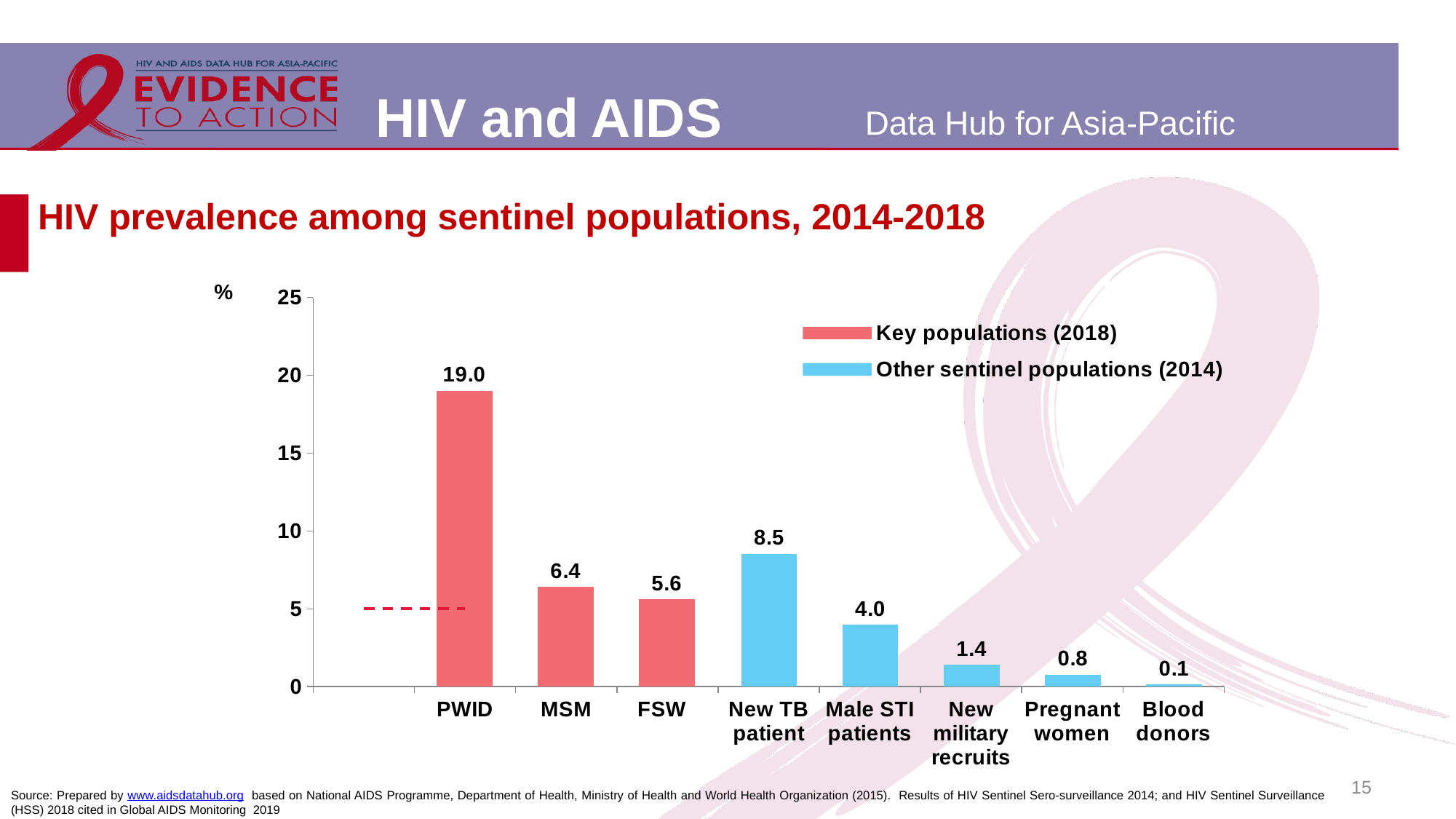
How many sentinel population categories are shown on the x axis? 8 What is the HIV prevalence value shown for PWID? 19.0 How many series does the legend list? 2 What is the difference between the HIV prevalence for PWID and for New TB patient? 10.5 What is the HIV prevalence value shown for Pregnant women? 0.8 Which has a higher HIV prevalence, Male STI patients or New military recruits? Male STI patients What kind of chart is shown on the slide? Bar chart Which sentinel population has the highest HIV prevalence on the chart? PWID Is the value for FSW greater or less than 5? greater What is the difference between the HIV prevalence for MSM and for FSW? 0.8 What is the HIV prevalence value shown for New TB patient? 8.5 Which sentinel population has the lowest HIV prevalence on the chart? Blood donors